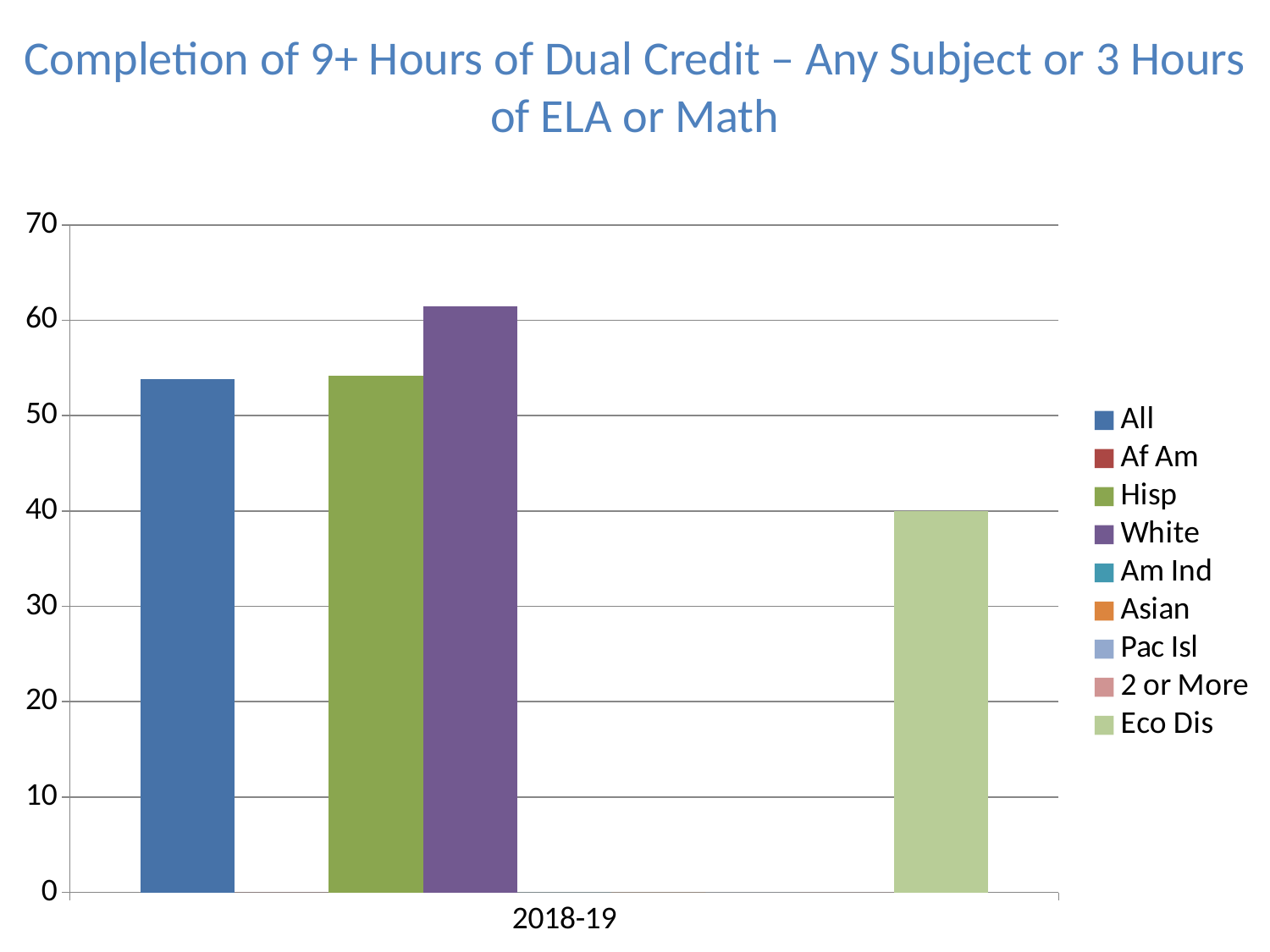
Is the value for White greater or less than 60? greater Which is larger, the value for Hisp or the value for Eco Dis? Hisp Which is larger, the value for White or the value for Eco Dis? White What is the x-axis category label? 2018-19 How many categories are shown on the x axis? 1 What kind of chart is shown on the slide? bar chart Which series has the tallest bar? White Is the value for All greater or less than 50? greater Is the value for Eco Dis greater or less than 50? less What is the title of the chart? Completion of 9+ Hours of Dual Credit – Any Subject or 3 Hours of ELA or Math How many series does the legend list? 9